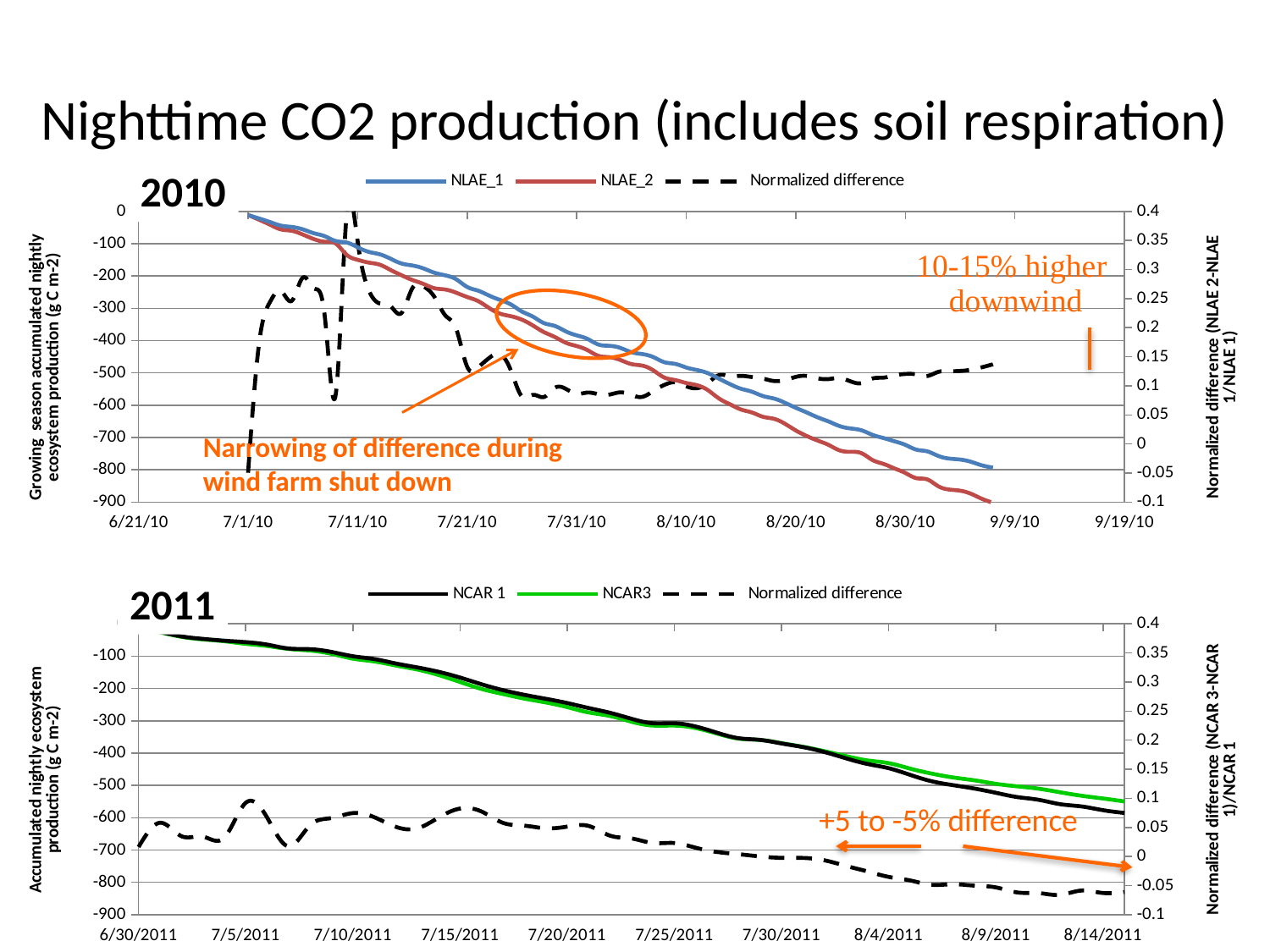
In the 2010 chart, which series is lower at the end of the period, NLAE_1 or NLAE_2? NLAE_2 How many series does the legend of the 2010 chart list? 3 In the 2010 chart, is the value of NLAE_1 at the end of the period greater or less than -700? less In the 2011 chart, which series is lower at the end of the period, NCAR 1 or NCAR3? NCAR 1 In the 2011 chart, is the Normalized difference at the end of the period greater or less than 0? less In the 2010 chart, which series is drawn as a dashed line? Normalized difference In the 2011 chart, does the NCAR 1 series rise or fall along the x axis? fall How many series does the legend of the 2011 chart list? 3 What type of chart is the 2010 chart at the top of the slide? line chart In the 2011 chart, is the value of NCAR3 at the end of the period greater or less than -400? less In the 2010 chart, does the NLAE_1 series rise or fall along the x axis? fall